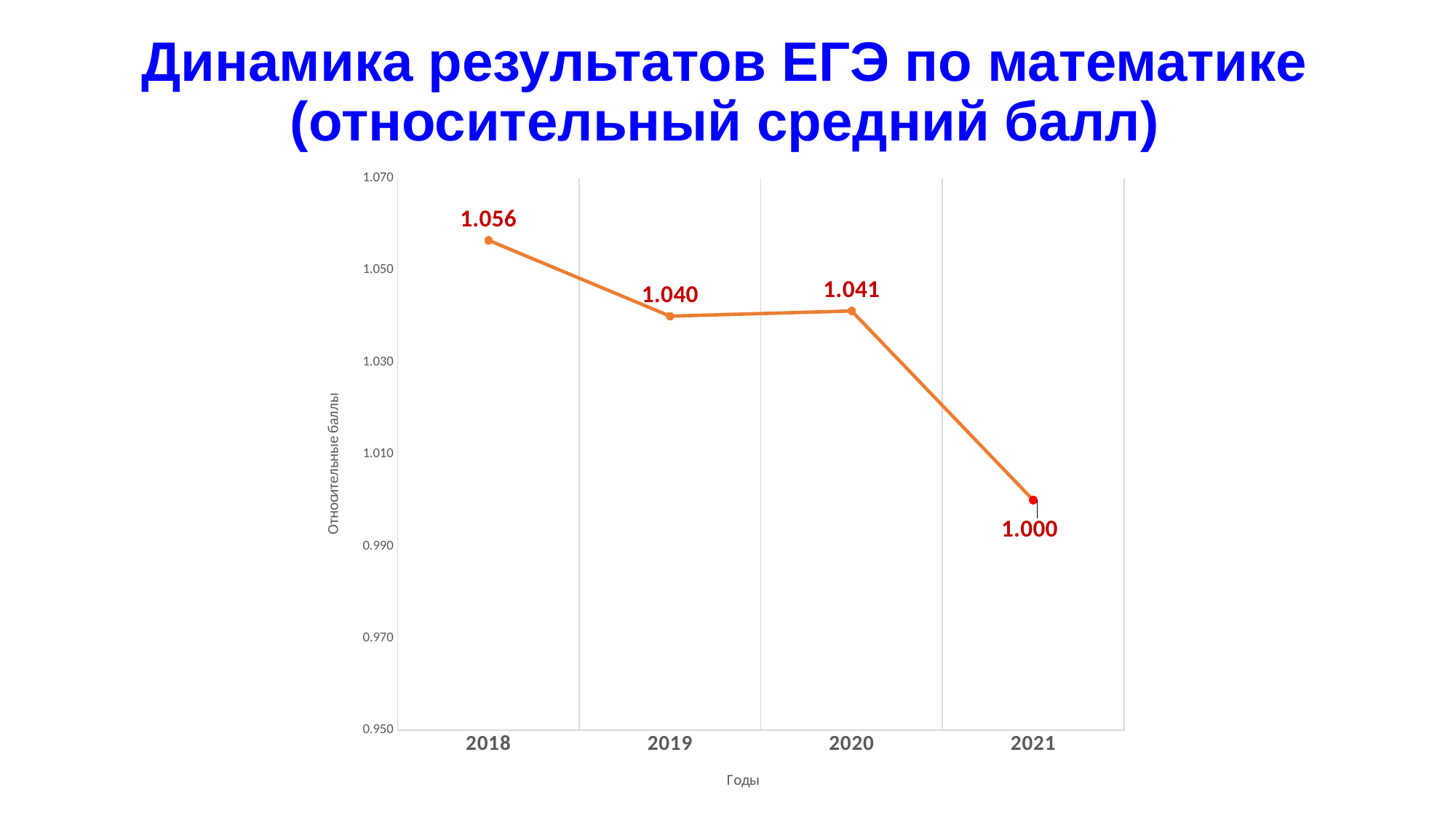
How many years are plotted on the chart? 4 Which year has the highest value? 2018 What is the value for 2019? 1.040 What is the value for 2018? 1.056 What is the value for 2021? 1.000 Which year has the lowest value? 2021 Which is larger, the value for 2019 or the value for 2021? 2019 What is the difference between the values for 2018 and 2019? 0.016 Do the values generally rise or fall from 2018 to 2021? fall What is the difference between the values for 2018 and 2021? 0.056 What is the value for 2020? 1.041 What kind of chart is shown on the slide? line chart